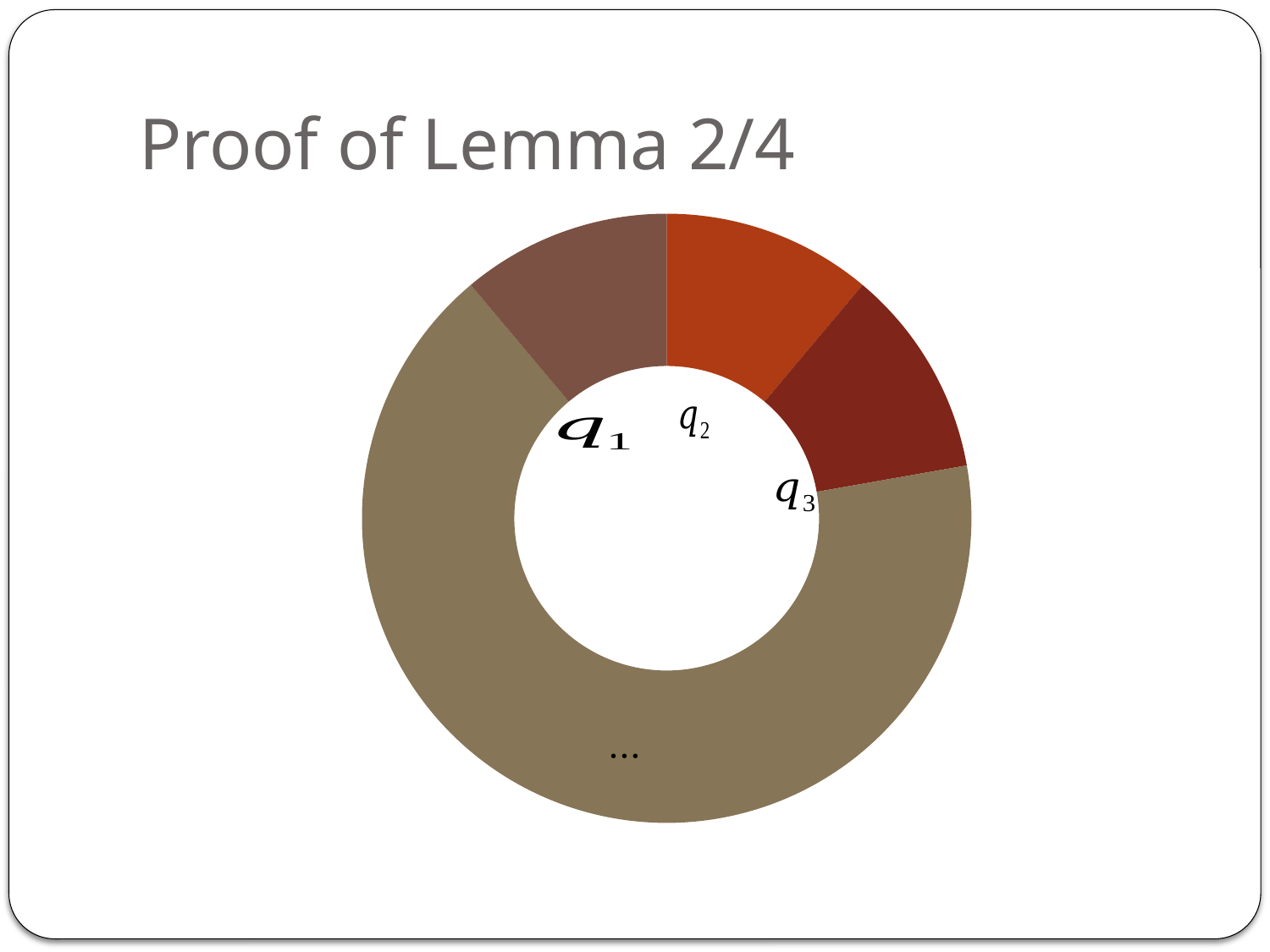
What kind of chart is shown on the slide? Doughnut (pie) chart How many slices does the doughnut chart have? 4 Does the slice labelled "..." take up more or less than half of the doughnut chart? more What is the title of the slide containing the doughnut chart? Proof of Lemma 2/4 Which slice is larger, the one labelled q3 or the one labelled "..."? ... Which slice of the doughnut chart is the largest? ... Which slice is larger, the one labelled q2 or the one labelled "..."? ... What are the labels shown inside the doughnut chart, in order from q1? q1, q2, q3, ...